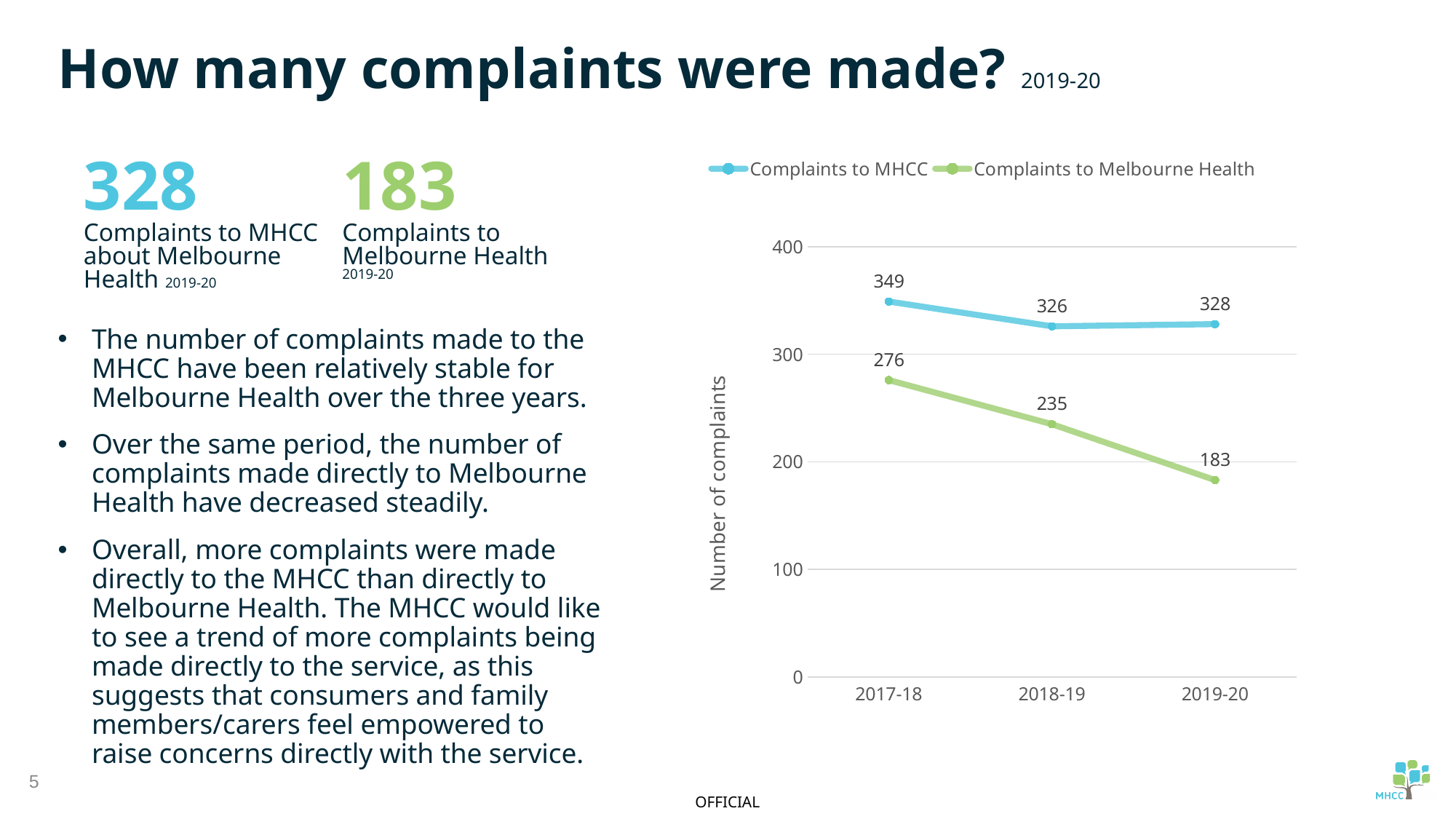
What is the label on the vertical axis of the chart? Number of complaints How many years are plotted along the x axis of the chart? 3 Do complaints to Melbourne Health rise or fall from 2017-18 to 2019-20? Fall What was the number of complaints to Melbourne Health in 2018-19? 235 In which year were complaints to MHCC highest? 2017-18 What is the difference between complaints to MHCC and complaints to Melbourne Health in 2019-20? 145 What kind of chart is shown on the slide? Line chart How many series does the chart legend list? 2 Which series had more complaints in 2018-19, Complaints to MHCC or Complaints to Melbourne Health? Complaints to MHCC What was the number of complaints to MHCC in 2017-18? 349 What was the number of complaints to Melbourne Health in 2019-20? 183 In which year were complaints to Melbourne Health lowest? 2019-20